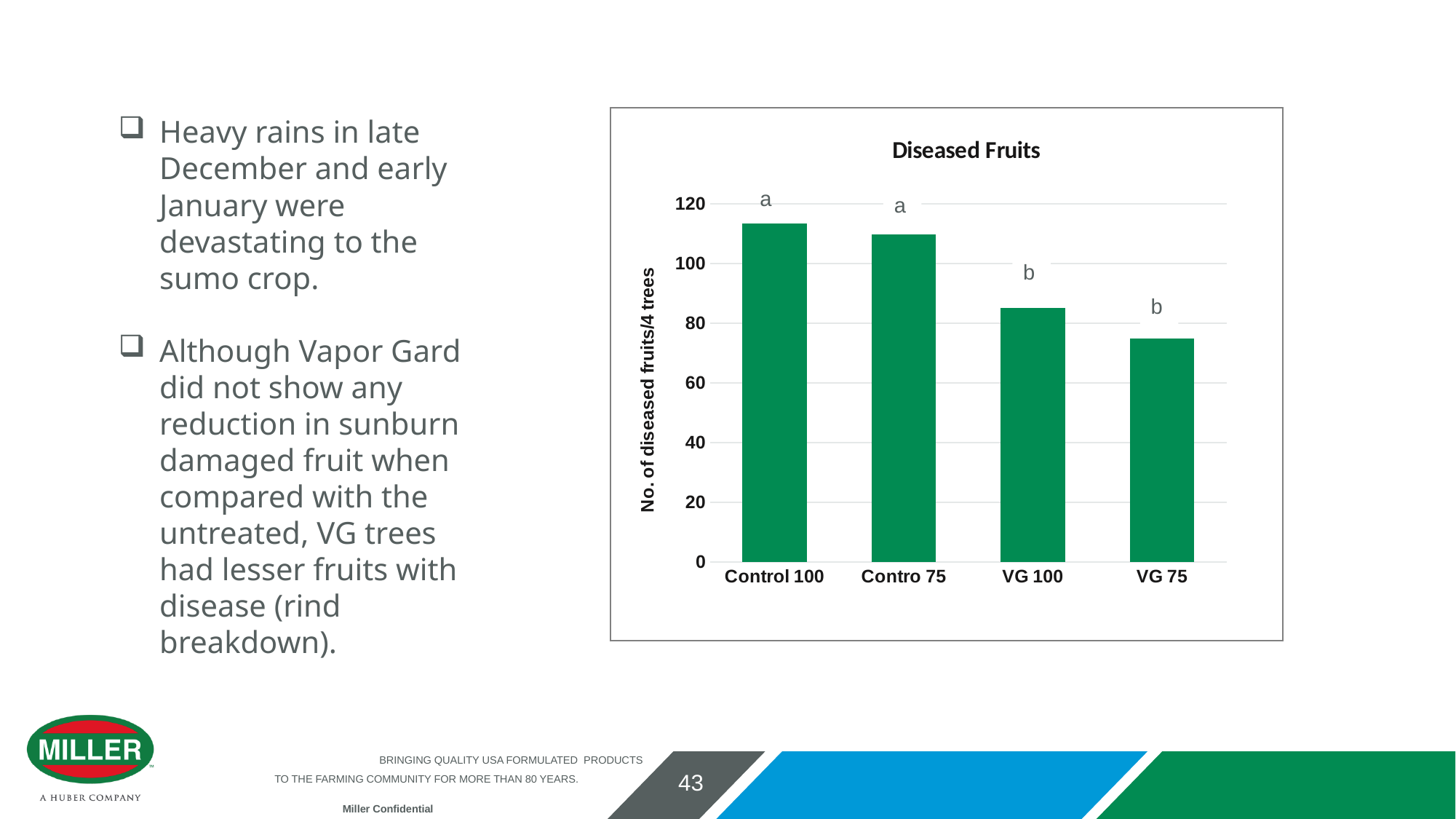
Do the values rise or fall moving from left to right across the categories? fall How many categories are plotted on the x axis of the chart? 4 Is the value for VG 75 greater or less than 80? less What is the label on the vertical axis of the chart? No. of diseased fruits/4 trees Is the value for Control 100 greater or less than 100? greater Which category has the lowest number of diseased fruits? VG 75 What kind of chart is shown on the slide? bar chart Which has more diseased fruits, Control 100 or VG 100? Control 100 Is the value for VG 100 greater or less than 100? less Which has fewer diseased fruits, Contro 75 or VG 75? VG 75 What is the title of the chart? Diseased Fruits